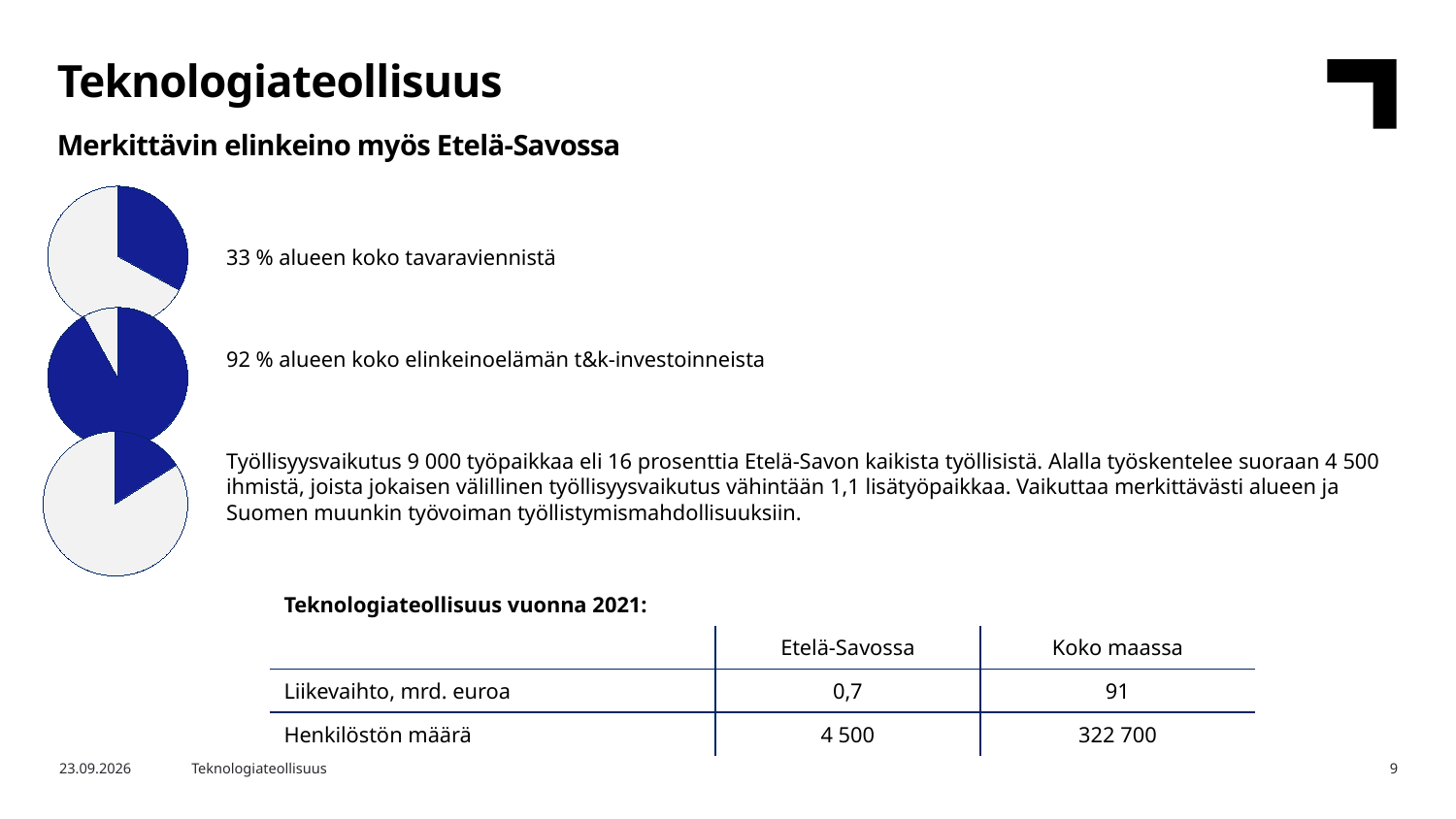
What colour is used for the highlighted slice in each pie chart? Dark blue What kind of charts are shown on the left side of the slide? Pie charts Which of the three pie charts has the smallest blue slice? The bottom one (työllisyysvaikutus, 16 prosenttia) By how many percentage points does the blue share in the middle pie chart (92 %) exceed the blue share in the top pie chart (33 %)? 59 percentage points In the bottom pie chart, what share of all employed people in Etelä-Savo does the blue slice represent? 16 prosenttia In the top pie chart, what share of the region's total goods exports (tavaravienti) does the blue slice represent? 33 % How many pie charts are on the slide? 3 What colour is the remaining (non-highlighted) portion of each pie chart? Light grey Which of the three pie charts has the largest blue slice? The middle one (t&k-investoinnit, 92 %) Is the blue slice larger in the top pie chart (tavaravienti) or in the bottom pie chart (työllisyysvaikutus)? The top pie chart (33 %) In the middle pie chart, what share of the region's business R&D investments (t&k-investoinnit) does the blue slice represent? 92 %